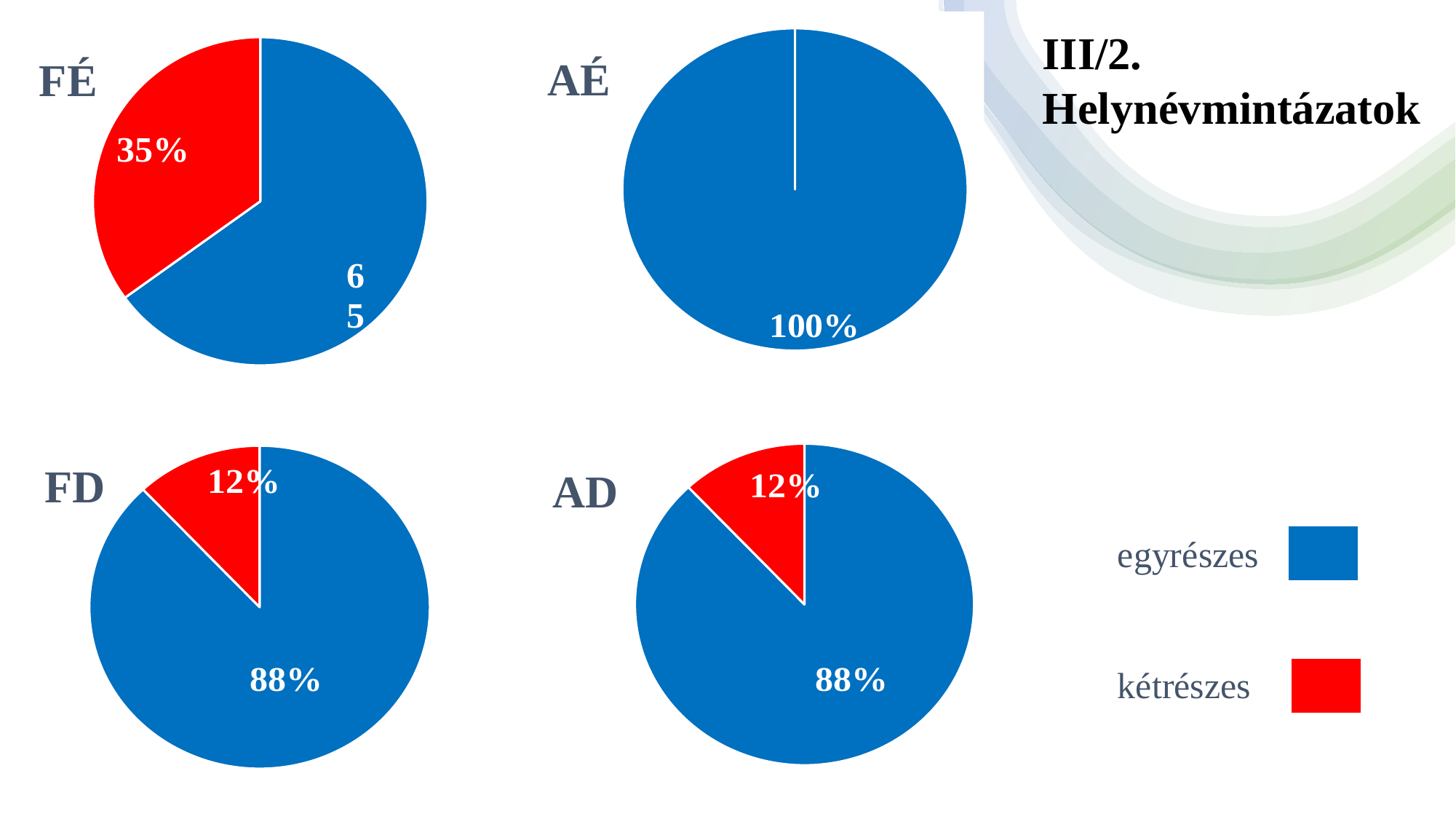
Which of the four pie charts has the largest kétrészes (red) share? FÉ How many categories does the legend list? 2 In the AÉ pie chart, what share is labelled for the egyrészes (blue) slice? 100% In the FÉ pie chart, what is the difference between the egyrészes and kétrészes shares? 30% In the FD pie chart, what is the difference between the egyrészes and kétrészes shares? 76% In the AD pie chart, what share is labelled for the egyrészes (blue) slice? 88% In the FD pie chart, what share is labelled for the kétrészes (red) slice? 12% How many pie charts are shown on the slide? 4 In the FÉ pie chart, what share is labelled for the kétrészes (red) slice? 35% In the FÉ pie chart, which slice is larger, egyrészes or kétrészes? egyrészes What colour represents kétrészes in the legend? red In the FÉ pie chart, what share is labelled for the egyrészes (blue) slice? 65%